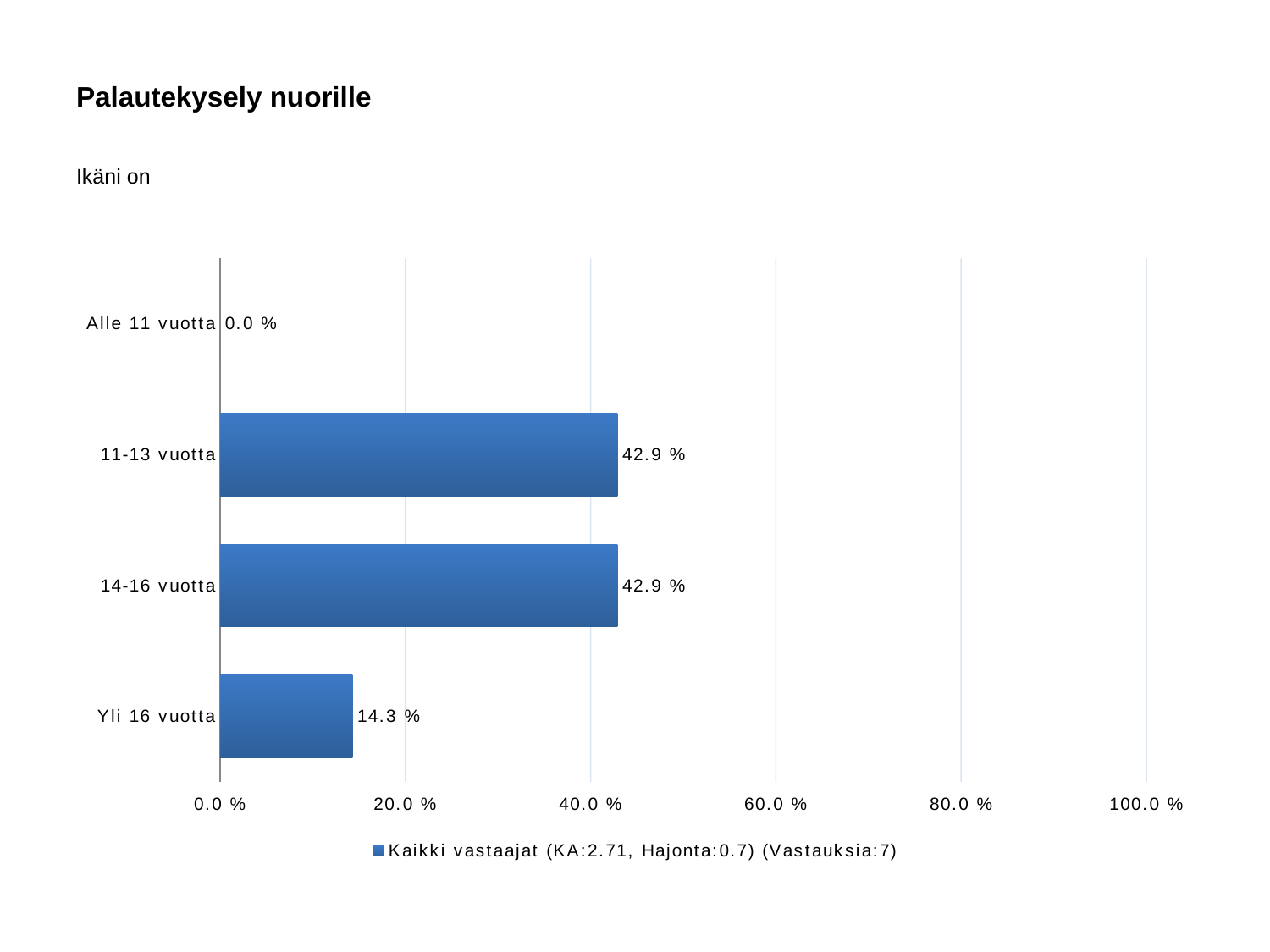
What kind of chart is shown on the slide? bar chart How many series does the legend list? 1 What is the value for Yli 16 vuotta? 14.3 % Is the value for Yli 16 vuotta greater or less than 20.0 %? less What is the value for Alle 11 vuotta? 0.0 % How many categories are shown on the chart? 4 What is the legend entry for the series shown? Kaikki vastaajat (KA:2.71, Hajonta:0.7) (Vastauksia:7) What is the value for 14-16 vuotta? 42.9 % What is the difference between the values for 14-16 vuotta and Yli 16 vuotta? 28.6 % What is the value for 11-13 vuotta? 42.9 % Which is larger, the value for 11-13 vuotta or the value for Yli 16 vuotta? 11-13 vuotta Which category has the lowest value? Alle 11 vuotta